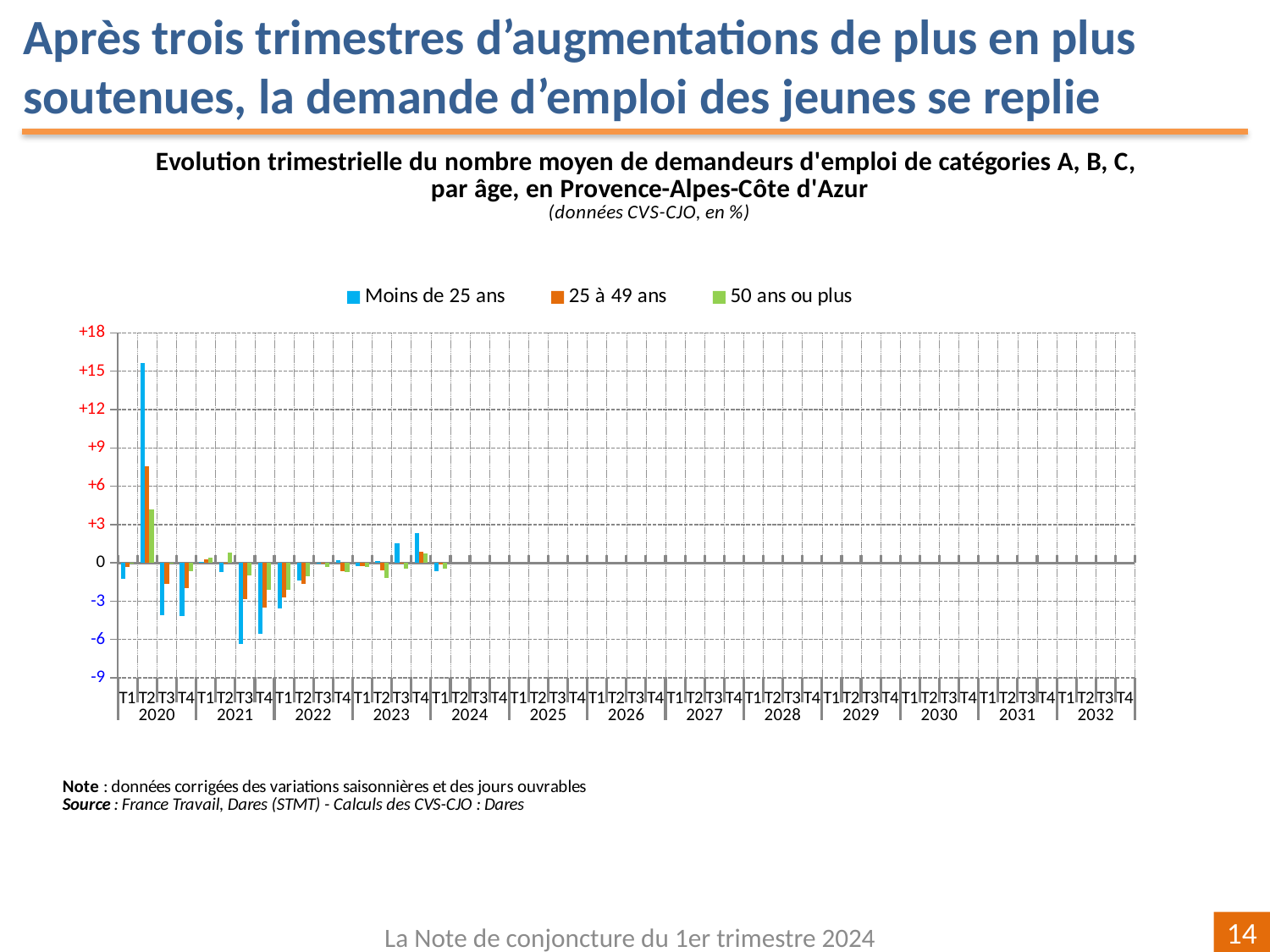
Is the value for '25 à 49 ans' in T2 2020 greater or less than +6? greater What is the subtitle in parentheses under the chart title? (données CVS-CJO, en %) In which quarter does the 'Moins de 25 ans' series reach its lowest value? T3 2021 In T2 2020, which series has the larger value: 'Moins de 25 ans' or '25 à 49 ans'? Moins de 25 ans Is the value for 'Moins de 25 ans' in T2 2020 greater or less than +12? greater In which quarter does the 'Moins de 25 ans' series reach its highest value? T2 2020 Is the value for 'Moins de 25 ans' in T3 2021 greater or less than -3? less What kind of chart is shown on the slide? bar chart Which series is shown in blue in the legend? Moins de 25 ans How many years are labelled along the x axis? 13 How many series does the legend list? 3